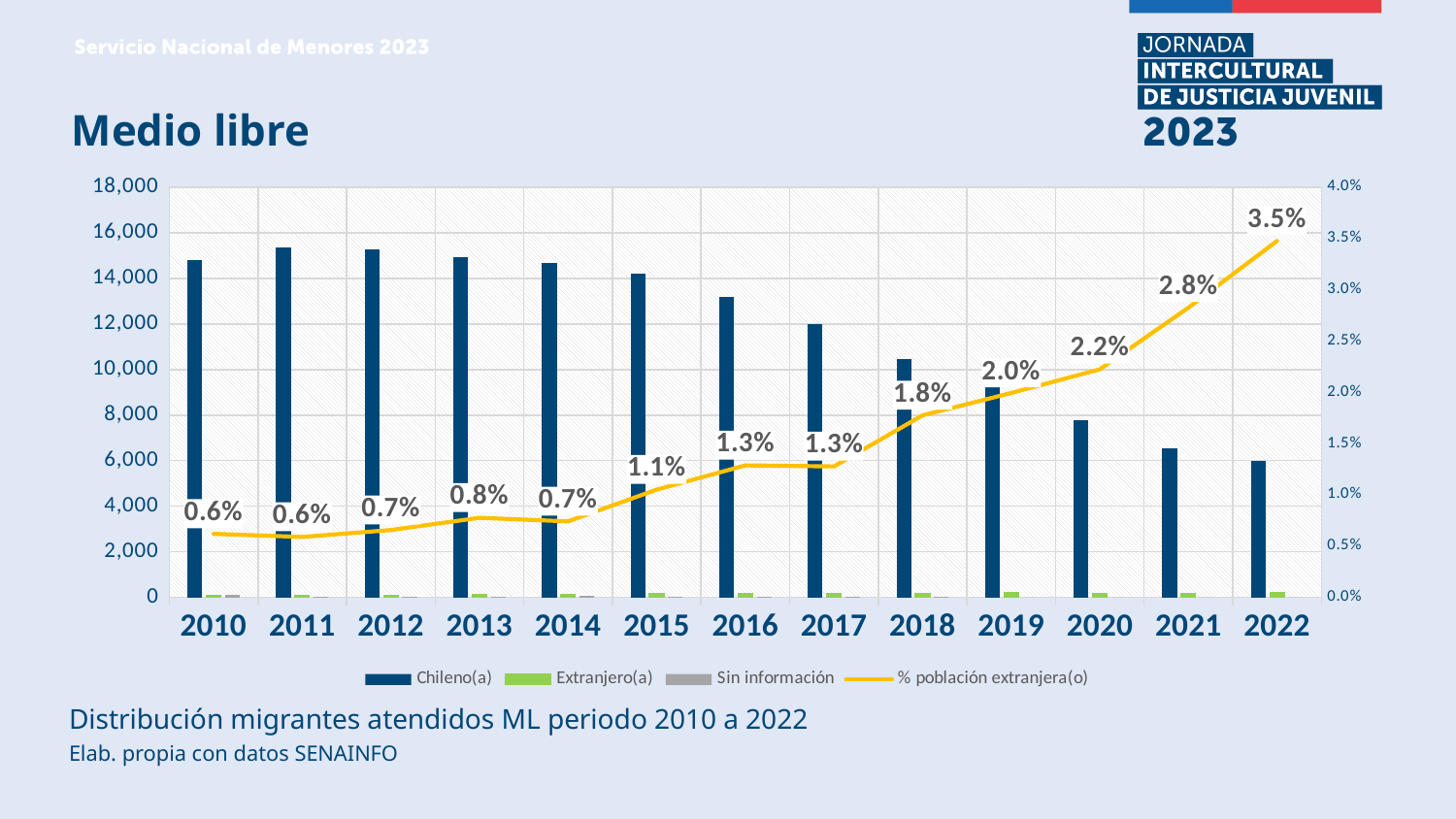
What is the value of % población extranjera(o) for 2022? 3.5% How many series does the legend list? 4 What is the value of % población extranjera(o) for 2010? 0.6% Is the Chileno(a) value for 2010 greater or less than 14,000? greater Does the % población extranjera(o) line rise or fall from 2010 to 2022? rise In which year is % población extranjera(o) highest? 2022 In which year is the Chileno(a) bar lowest? 2022 Is the Chileno(a) value for 2020 greater or less than 8,000? less How many years are shown on the x axis? 13 What is the value of % población extranjera(o) for 2015? 1.1% Which is larger, the % población extranjera(o) value for 2018 or for 2017? 2018 What is the difference between the % población extranjera(o) values for 2022 and 2010? 2.9 percentage points